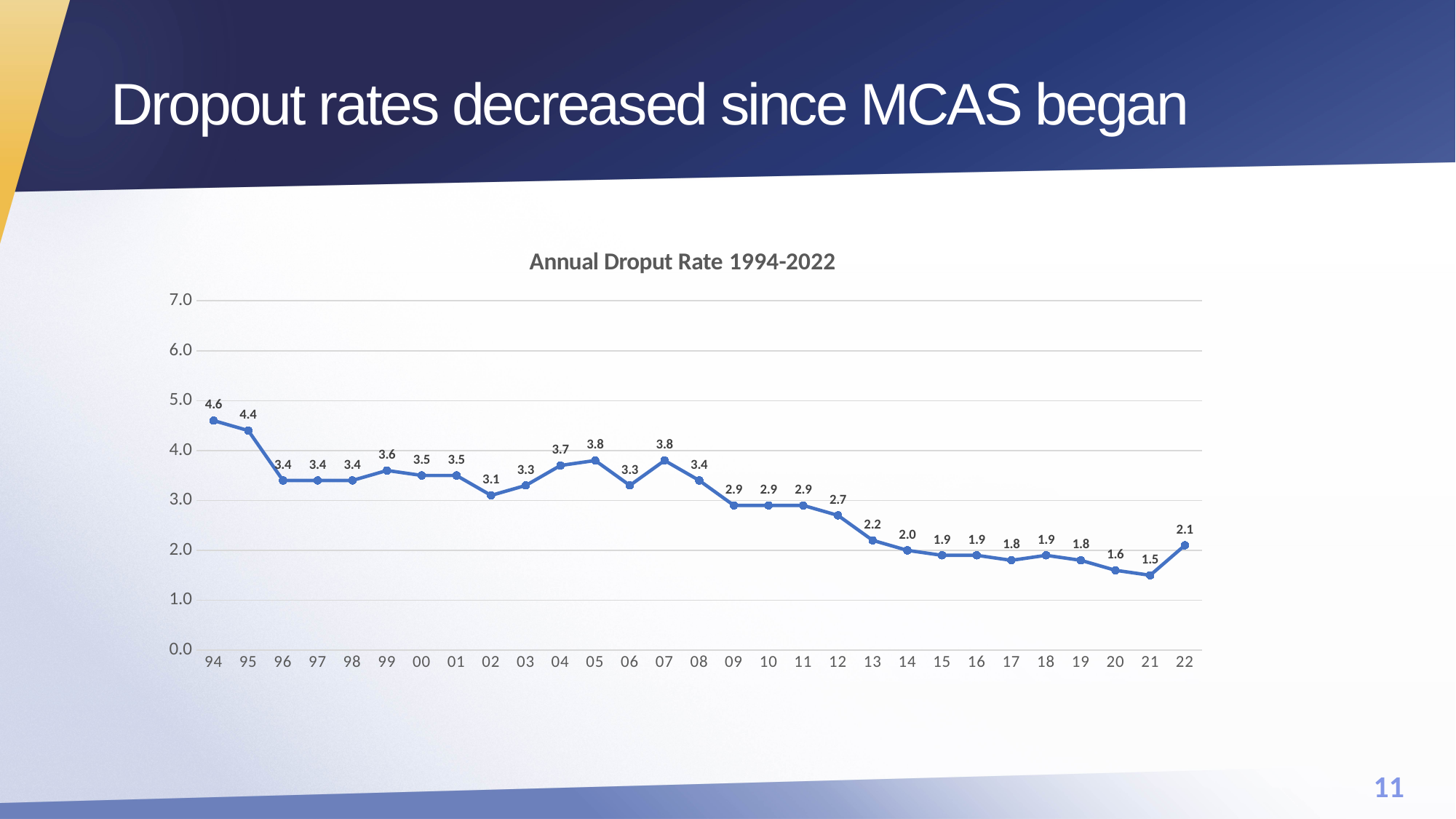
What is the title of the chart? Annual Droput Rate 1994-2022 Is the dropout rate for 13 greater or less than 3.0? less Which is larger, the dropout rate in 05 or in 06? 05 Which year has the lowest dropout rate? 21 What is the dropout rate for 94? 4.6 Which year has the highest dropout rate? 94 What kind of chart is shown on the slide? line chart What is the dropout rate for 12? 2.7 How many years are plotted on the chart? 29 What is the dropout rate for 22? 2.1 What is the difference between the dropout rate in 22 and in 21? 0.6 What is the difference between the dropout rate in 94 and in 21? 3.1